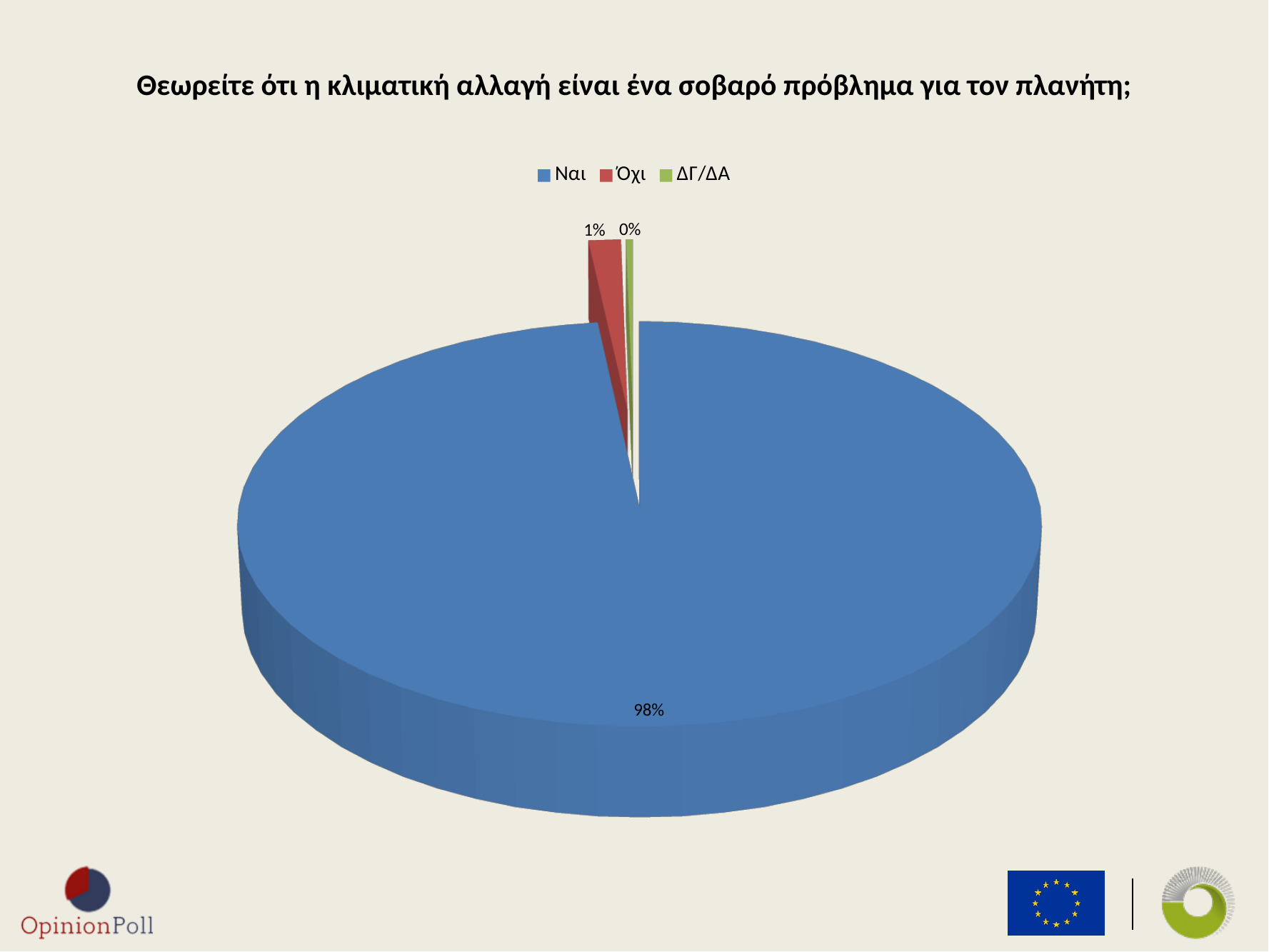
What kind of chart is shown on the slide? pie chart What is the value for ΔΓ/ΔΑ? 0% What is the value for Όχι? 1% How many entries does the legend list? 3 Which category has the largest share of the pie? Ναι What is the value for Ναι? 98% What is the title of the chart? Θεωρείτε ότι η κλιματική αλλαγή είναι ένα σοβαρό πρόβλημα για τον πλανήτη; What is the difference between the values for Ναι and Όχι? 97% Which is larger, the value for Όχι or the value for ΔΓ/ΔΑ? Όχι How many categories does the pie chart show? 3 What colour is the slice for Ναι? blue Which category has the smallest share of the pie? ΔΓ/ΔΑ